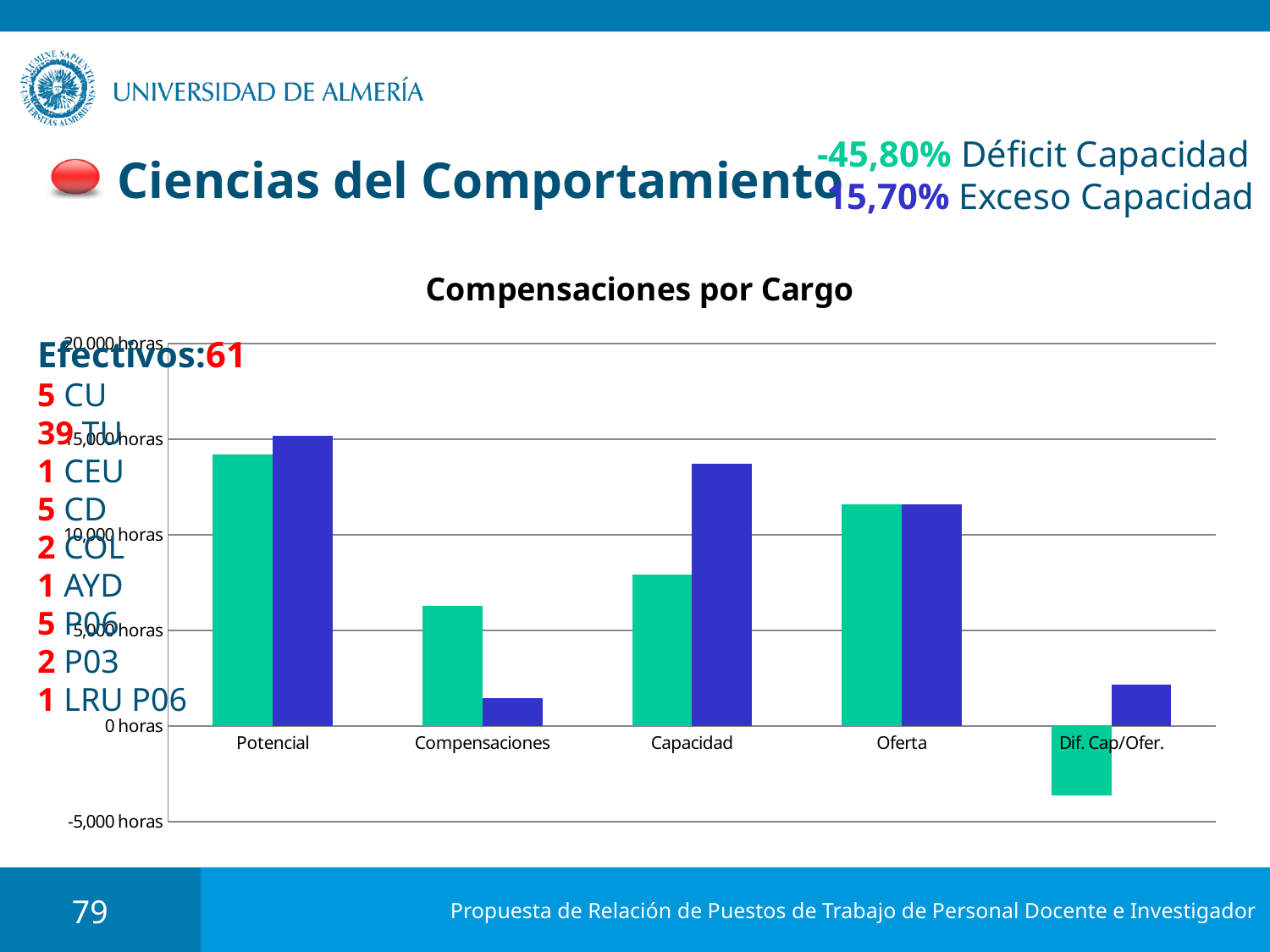
For Compensaciones, which bar is larger, the teal one or the blue one? the teal one Is the teal bar for Dif. Cap/Ofer. greater or less than 0 horas? less Is the blue bar for Compensaciones greater or less than 5,000 horas? less Which category has the tallest teal bar? Potencial Is the blue bar for Capacidad greater or less than 10,000 horas? greater How many categories are shown on the x axis of the chart? 5 Which category has the lowest teal bar? Dif. Cap/Ofer. For Capacidad, which bar is larger, the teal one or the blue one? the blue one What kind of chart is shown on the slide? bar chart What unit is used on the vertical axis of the chart? horas What is the title of the chart? Compensaciones por Cargo